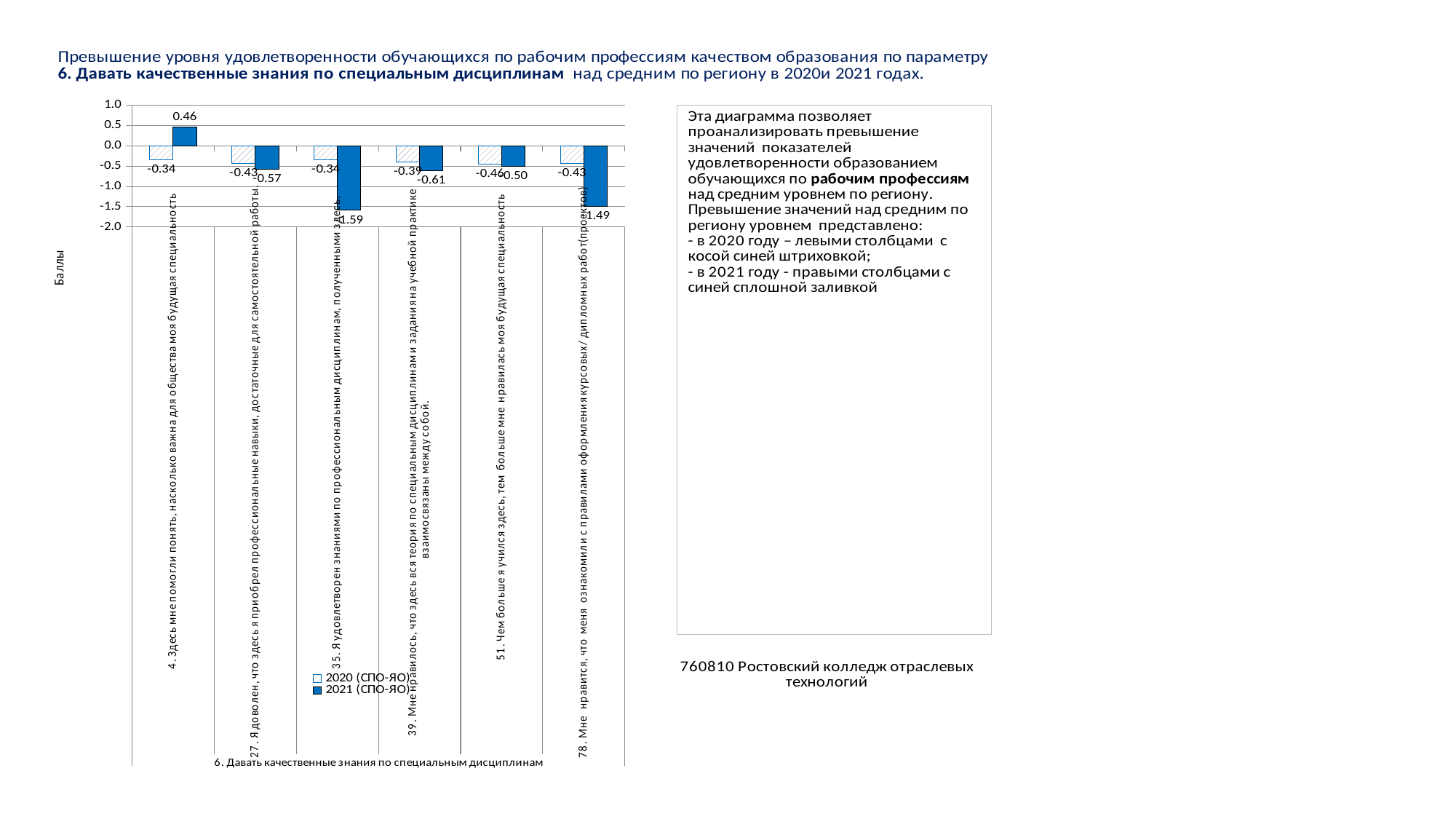
Which statement has the highest 2021 (СПО-ЯО) value? 4. Здесь мне помогли понять, насколько важна для общества моя будущая специальность How many series does the legend list? 2 How many categories (statements) are plotted on the x axis? 6 What is the 2021 (СПО-ЯО) value for statement 4 (Здесь мне помогли понять, насколько важна для общества моя будущая специальность)? 0.46 What is the difference between the 2020 and 2021 (СПО-ЯО) values for statement 39 (Мне нравилось, что здесь вся теория по специальным дисциплинам и задания на учебной практике взаимосвязаны между собой)? 0.22 For statement 27 (Я доволен, что здесь я приобрел профессиональные навыки, достаточные для самостоятельной работы), which is larger: the 2020 (СПО-ЯО) value or the 2021 (СПО-ЯО) value? 2020 (СПО-ЯО) What kind of chart is shown on the slide? bar chart What is the 2021 (СПО-ЯО) value for statement 78 (Мне нравится, что меня ознакомили с правилами оформления курсовых/дипломных работ)? -1.49 What is the 2020 (СПО-ЯО) value for statement 35 (Я удовлетворен знаниями по профессиональным дисциплинам, полученными здесь)? -0.34 What is the label of the vertical axis? Баллы What is the 2020 (СПО-ЯО) value for statement 51 (Чем больше я учился здесь, тем больше мне нравилась моя будущая специальность)? -0.46 Which statement has the lowest 2021 (СПО-ЯО) value? 35. Я удовлетворен знаниями по профессиональным дисциплинам, полученными здесь